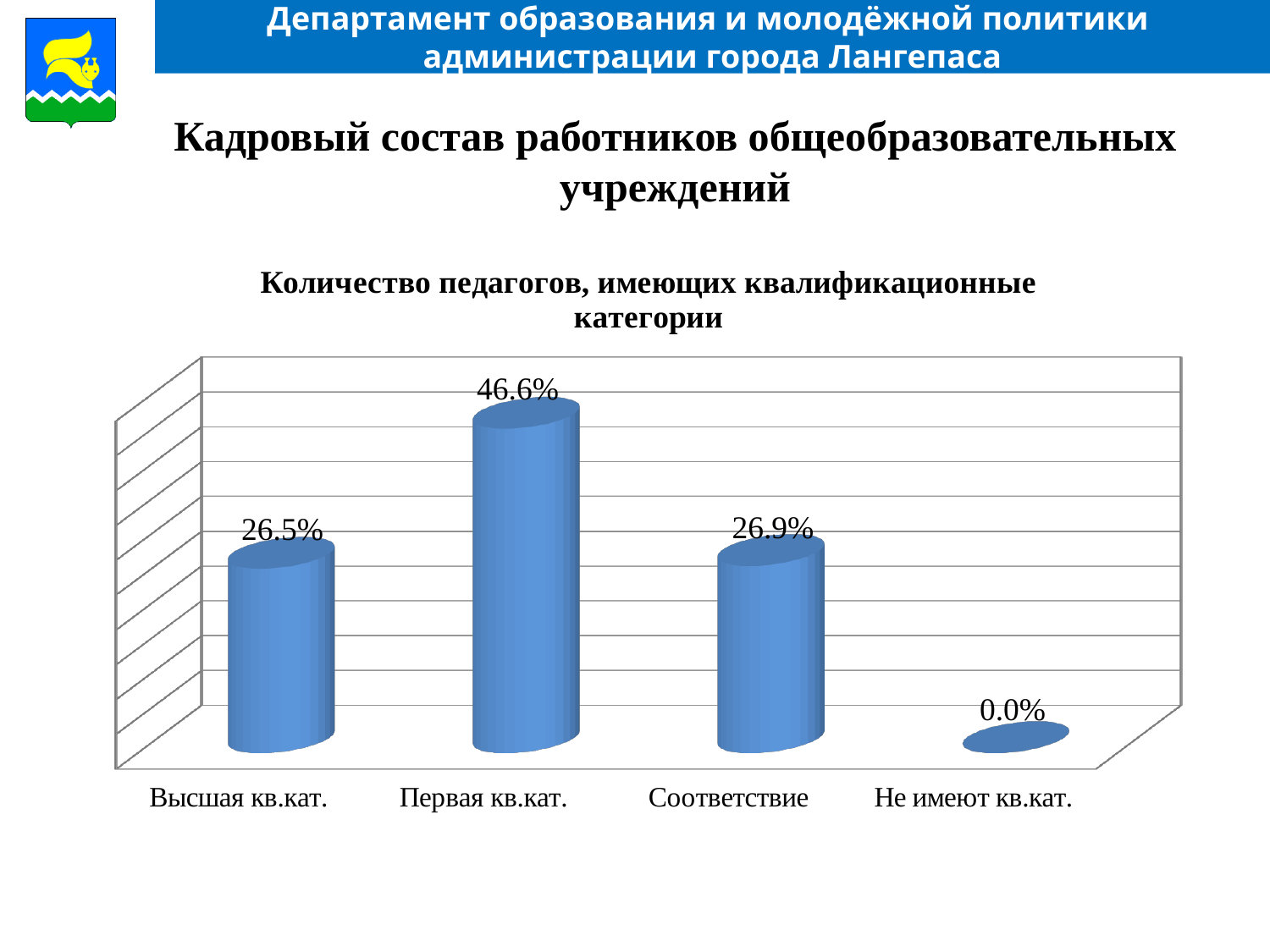
Which is larger, the value for Первая кв.кат. or the value for Соответствие? Первая кв.кат. What is the difference between the values for Соответствие and Высшая кв.кат.? 0.4% How many categories are shown on the chart? 4 What is the value for Высшая кв.кат.? 26.5% What is the value for Не имеют кв.кат.? 0.0% What kind of chart is shown on the slide? Bar chart What is the value for Соответствие? 26.9% What is the difference between the values for Первая кв.кат. and Высшая кв.кат.? 20.1% Which category has the lowest value? Не имеют кв.кат. Which category has the highest value? Первая кв.кат. What is the title of the chart? Количество педагогов, имеющих квалификационные категории What is the value for Первая кв.кат.? 46.6%